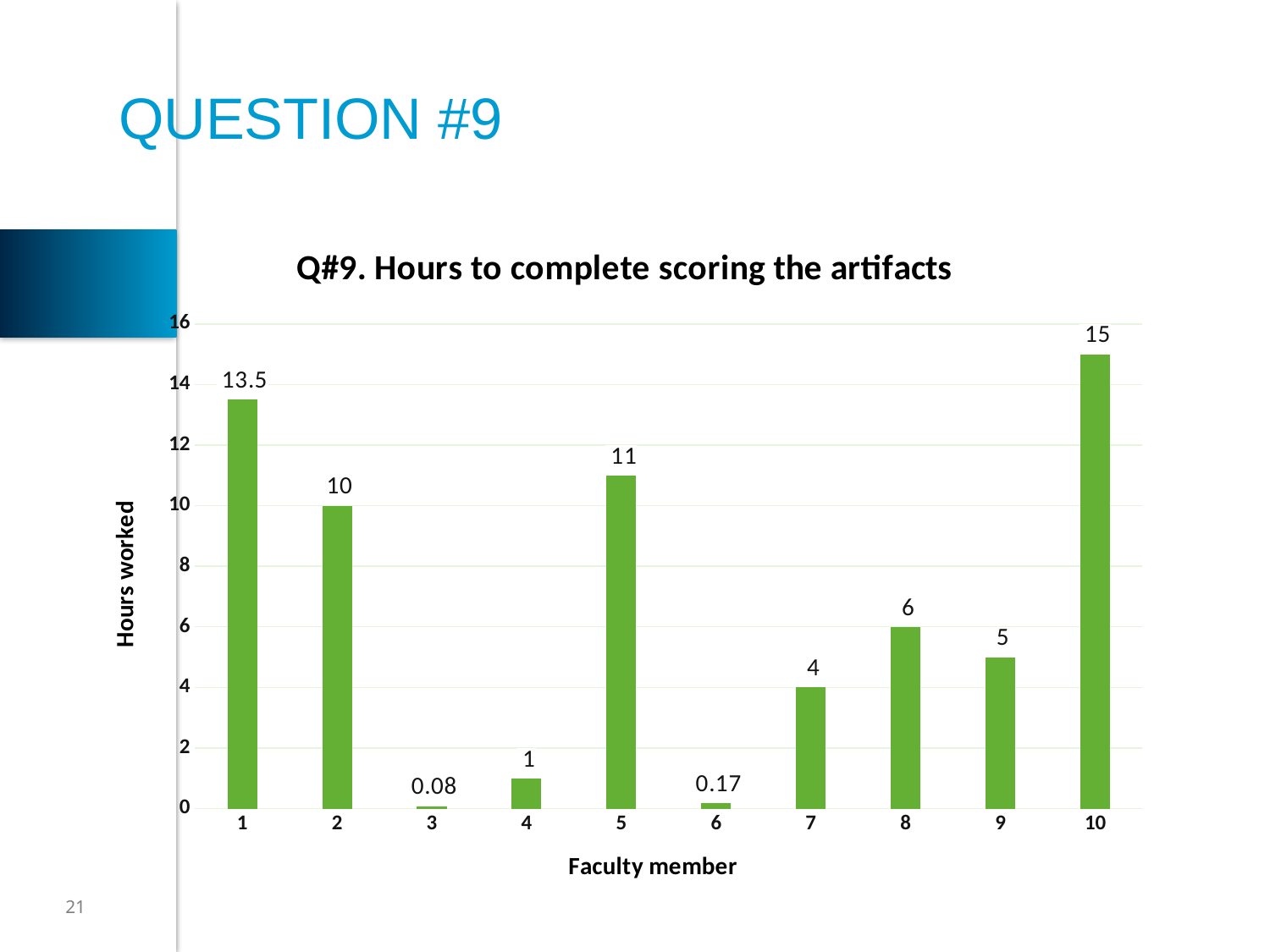
What is the value for faculty member 3? 0.08 How many hours did faculty member 6 work? 0.17 Is the value for faculty member 7 greater or less than 6? less What kind of chart is shown on the slide? Bar chart What is the difference in hours worked between faculty member 10 and faculty member 1? 1.5 Which faculty member has the highest hours worked? 10 What is the value for faculty member 1? 13.5 Which faculty member has the lowest hours worked? 3 Which has more hours worked, faculty member 8 or faculty member 9? Faculty member 8 How many faculty members are shown on the x axis? 10 What is the title of the chart? Q#9. Hours to complete scoring the artifacts What is the difference in hours worked between faculty member 5 and faculty member 2? 1